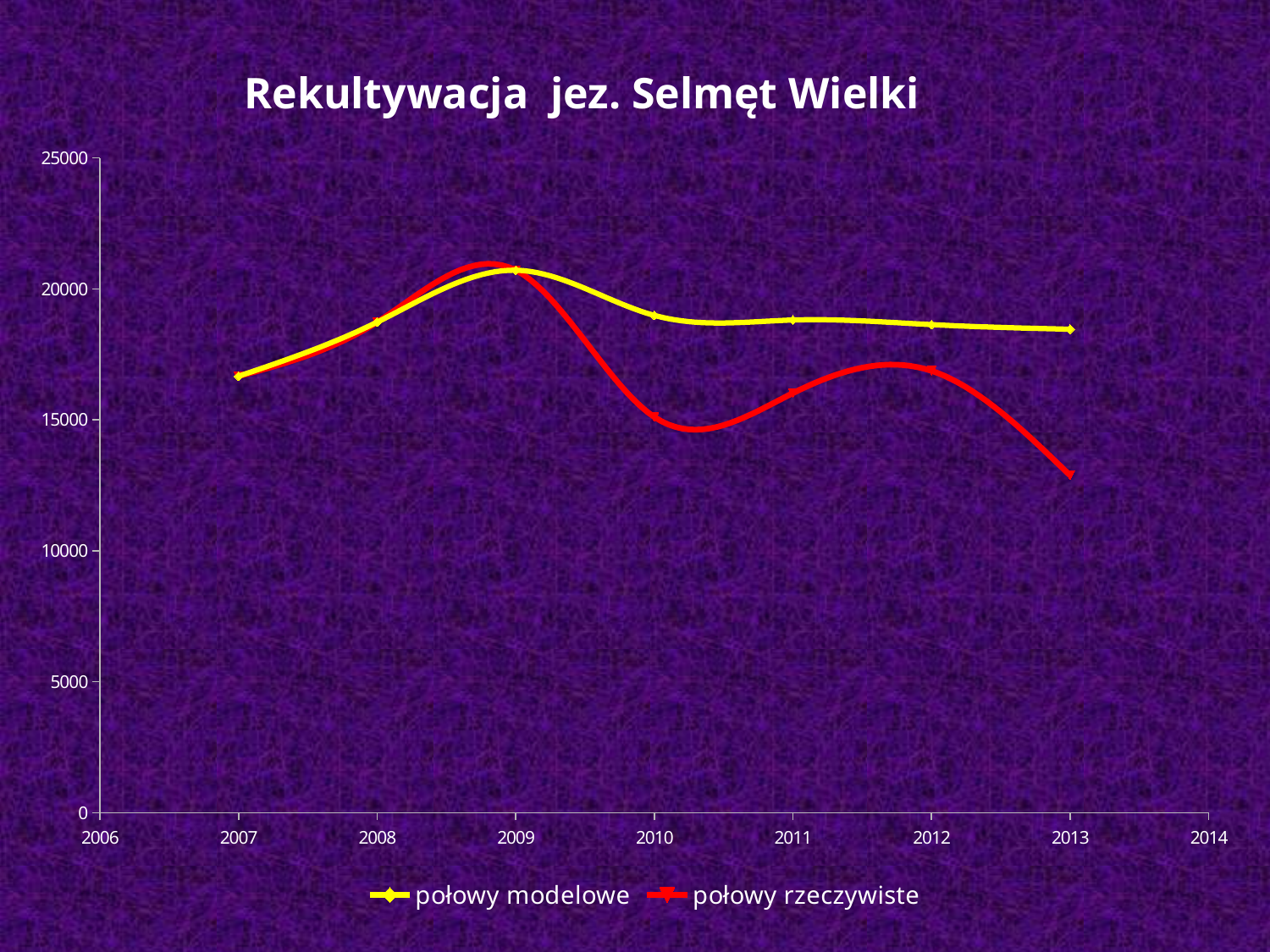
How many series does the legend list? 2 How many data points does the 'połowy modelowe' series have? 7 What is the title of the chart? Rekultywacja jez. Selmęt Wielki Which colour is used for the 'połowy rzeczywiste' series? red Is the value for 'połowy modelowe' in 2007 greater or less than 15000? greater Does the 'połowy rzeczywiste' series rise or fall from 2012 to 2013? fall In which year is the value for 'połowy rzeczywiste' highest? 2009 Is the value for 'połowy rzeczywiste' in 2013 greater or less than 15000? less What kind of chart is shown on the slide? line chart Is the value for 'połowy modelowe' in 2009 greater or less than 20000? greater In 2010, which series has the larger value, 'połowy modelowe' or 'połowy rzeczywiste'? połowy modelowe In which year is the value for 'połowy rzeczywiste' lowest? 2013